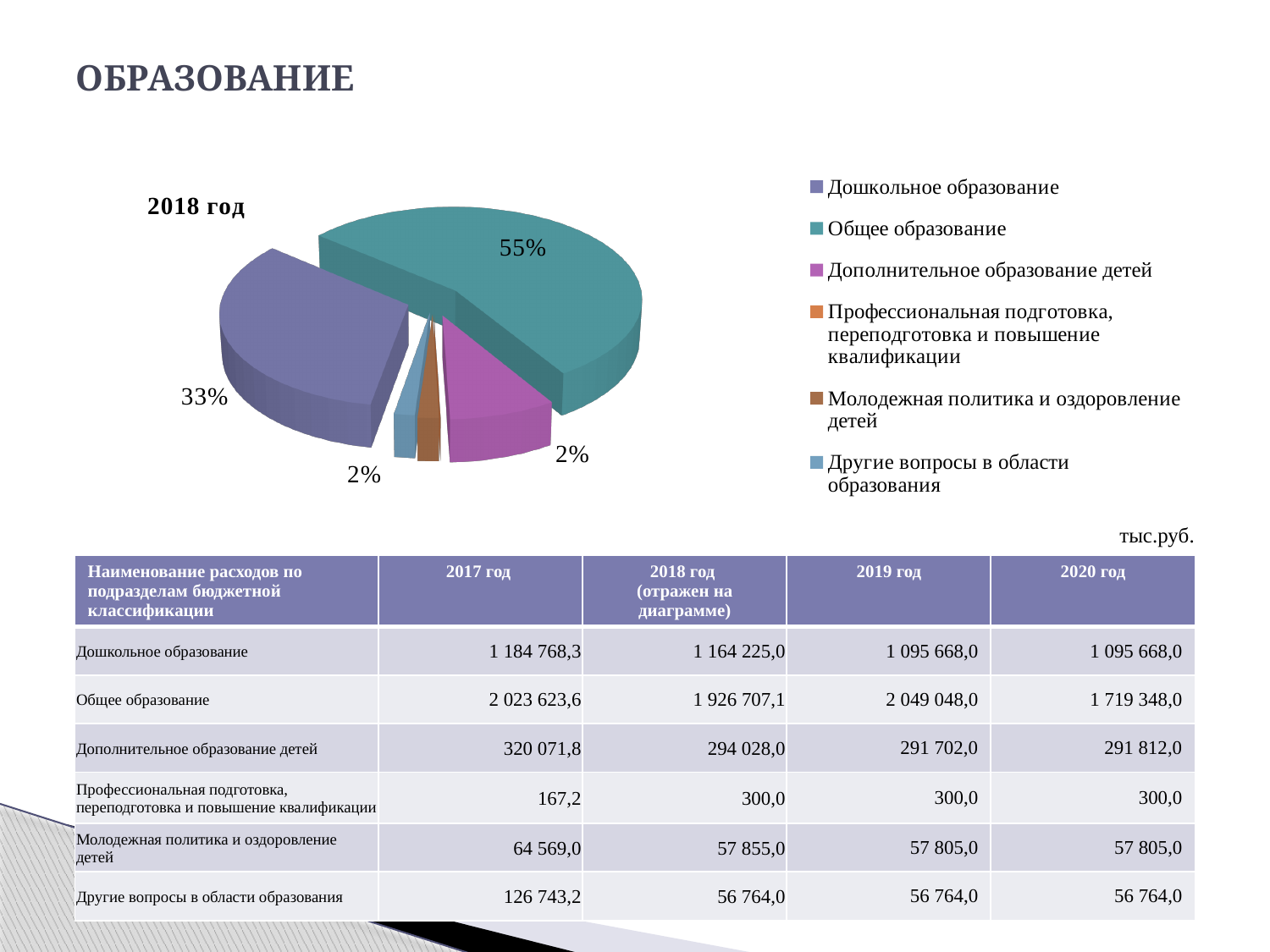
Which category has the largest slice of the pie? Общее образование How many categories does the legend of the pie chart list? 6 What share of the pie does Дошкольное образование have? 33% What share of the pie does Общее образование have? 55% What is the title of the pie chart? 2018 год What kind of chart is shown on the slide? pie chart By how many percentage points does the share of Общее образование exceed that of Дошкольное образование? 22% Which is larger in the pie chart: Общее образование or Дошкольное образование? Общее образование